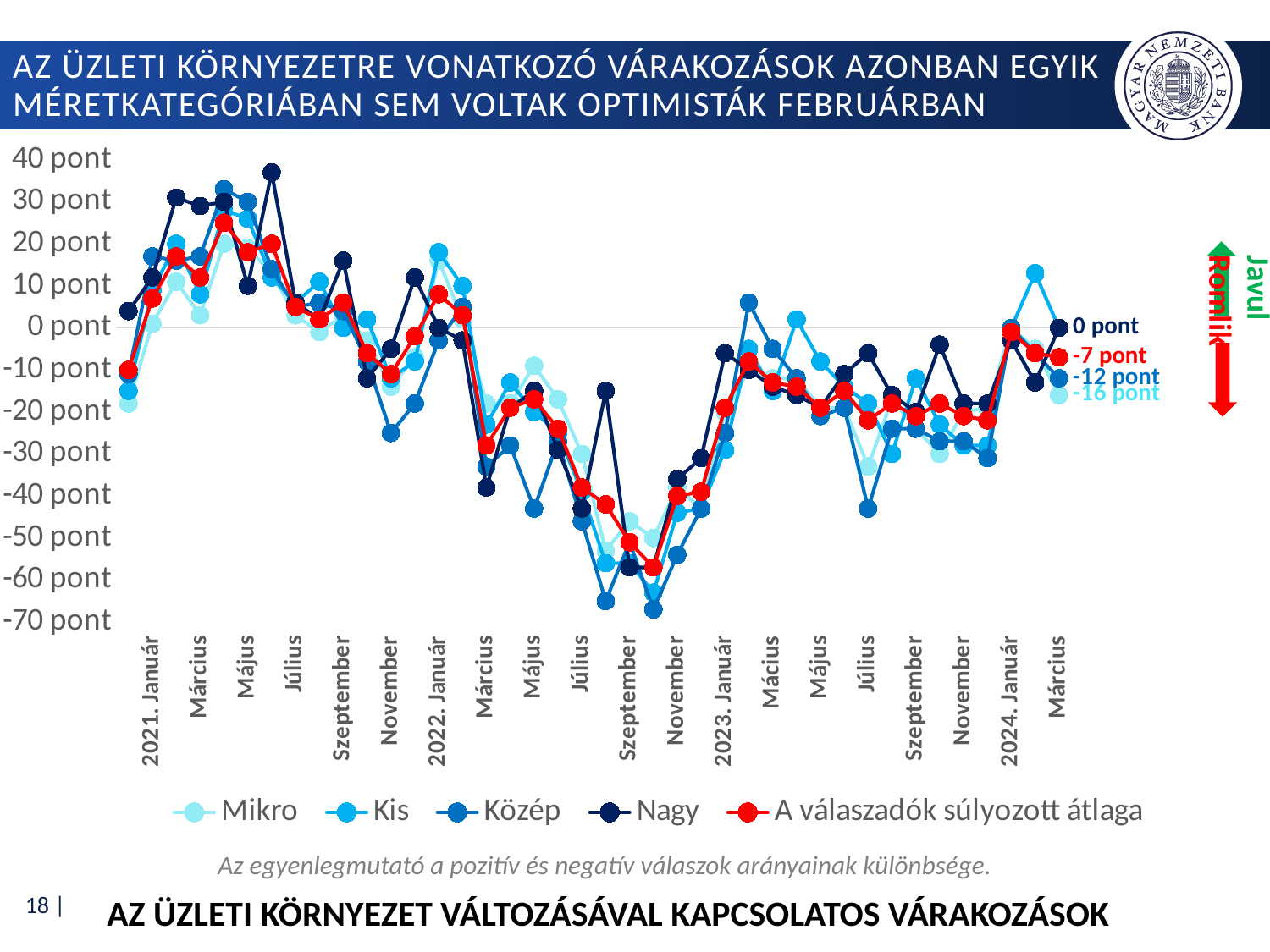
What is the value of the Mikro series at the last point (2024 Március)? -16 pont What is the value of the Nagy series at the last point (2024 Március)? 0 pont How many series does the legend list? 5 At the last point (2024 Március), which is higher: Nagy or 'A válaszadók súlyozott átlaga'? Nagy At the last point (2024 Március), what is the difference between the Nagy value and the 'A válaszadók súlyozott átlaga' value? 7 pont Is the value for Kis in 2024 Január greater or less than 10 pont? less What kind of chart is shown on the slide? line chart Which series has the lowest value at the last point (2024 Március)? Mikro Which legend entry is drawn in red? A válaszadók súlyozott átlaga What is the value of 'A válaszadók súlyozott átlaga' at the last point (2024 Március)? -7 pont Does the Nagy series rise or fall from 2021 Január to 2021 Március? rise